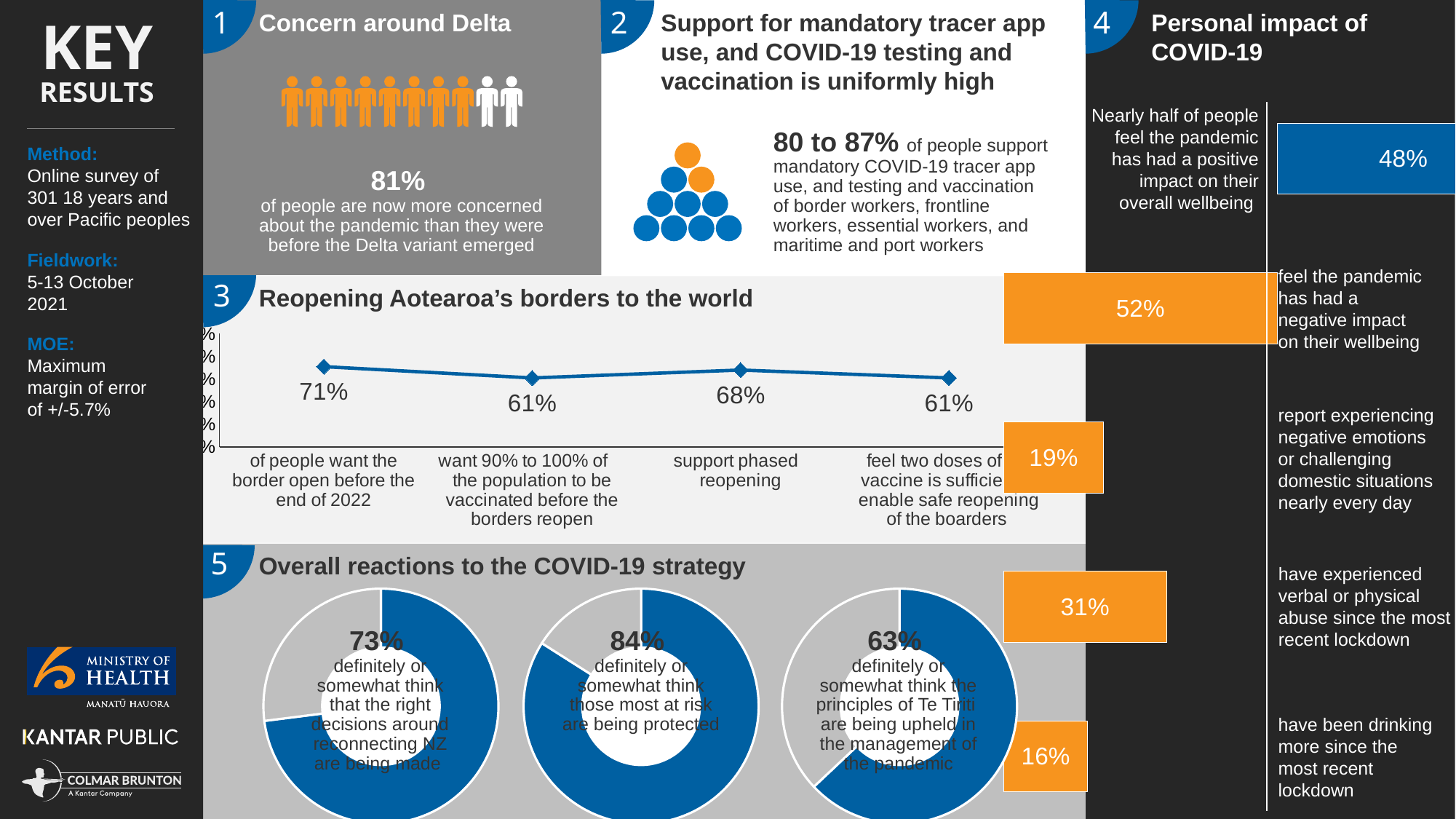
In the 'Personal impact of COVID-19' bar chart, how many bars are shown? 5 In the 'Reopening Aotearoa's borders to the world' chart, how many data points are plotted? 4 In the 'Reopening Aotearoa's borders to the world' chart, what is the difference between the value for wanting the border open before the end of 2022 and the value for wanting 90% to 100% of the population vaccinated before borders reopen? 10 percentage points In the 'Reopening Aotearoa's borders to the world' chart, what percentage support phased reopening? 68% In the 'Personal impact of COVID-19' bar chart, what is the difference between the share who feel the pandemic had a negative impact on their wellbeing and the share who feel it had a positive impact? 4 percentage points What type of chart is used in the 'Reopening Aotearoa's borders to the world' section? line chart In the 'Overall reactions to the COVID-19 strategy' section, which of the three donut charts shows the largest share? 84% (those most at risk are being protected) In the 'Personal impact of COVID-19' bar chart, what percentage feel the pandemic has had a negative impact on their wellbeing? 52% In the 'Personal impact of COVID-19' bar chart, what percentage have experienced verbal or physical abuse since the most recent lockdown? 31% In the 'Reopening Aotearoa's borders to the world' chart, which category has the highest value? of people want the border open before the end of 2022 In the 'Personal impact of COVID-19' bar chart, which category has the lowest value? have been drinking more since the most recent lockdown In the 'Reopening Aotearoa's borders to the world' chart, what percentage of people want the border open before the end of 2022? 71%